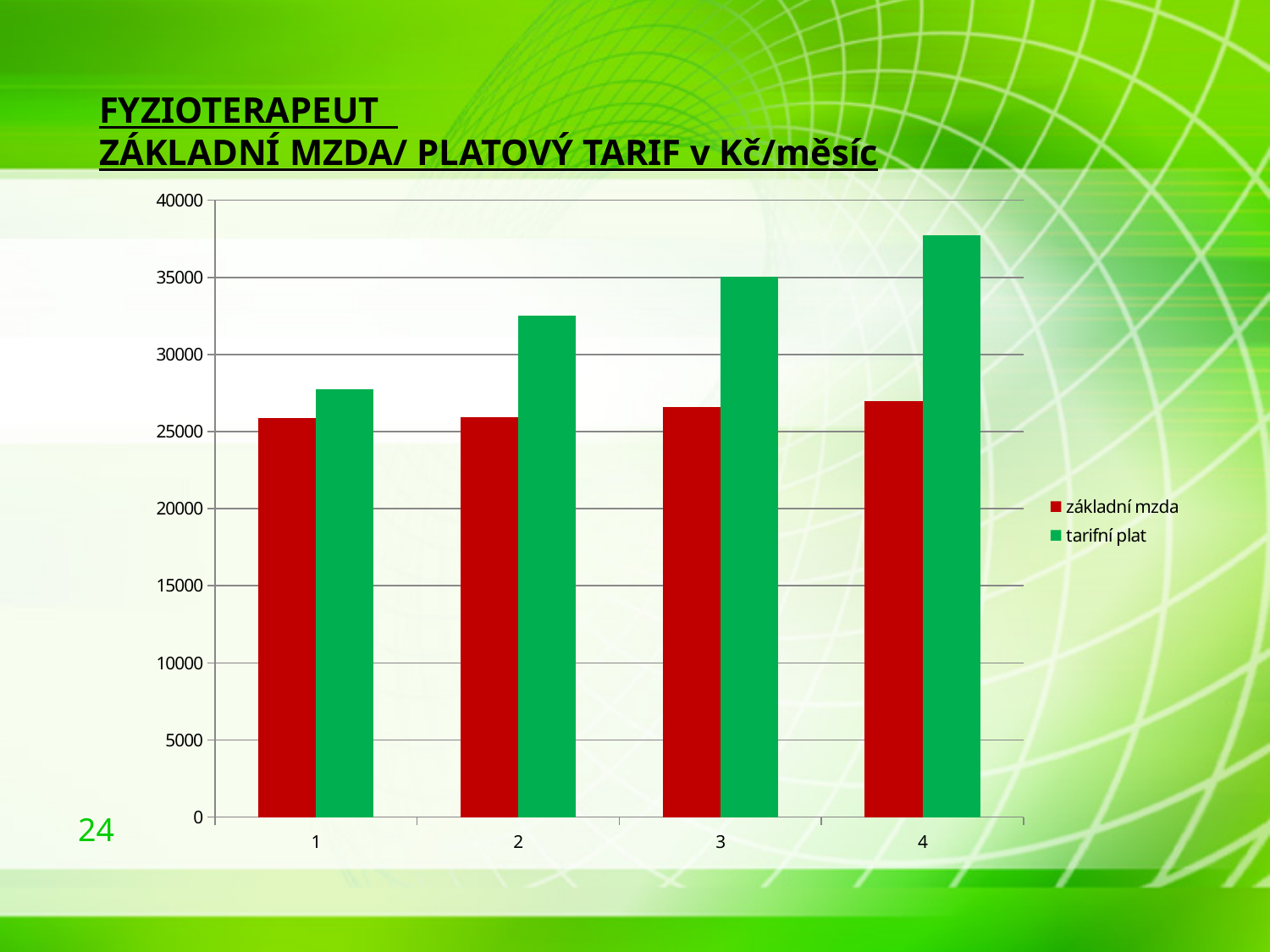
Is the value of tarifní plat for category 2 greater or less than 30000? greater Is the value of tarifní plat for category 4 greater or less than 35000? greater Which colour represents tarifní plat in the chart? green Is the value of tarifní plat for category 1 greater or less than 30000? less What kind of chart is shown on the slide? bar chart How many series does the legend list? 2 Which category has the lowest value for tarifní plat? 1 Do the values of tarifní plat rise or fall from category 1 to category 4? rise Which category has the highest value for tarifní plat? 4 For category 2, which is larger: základní mzda or tarifní plat? tarifní plat How many categories are shown on the x axis? 4